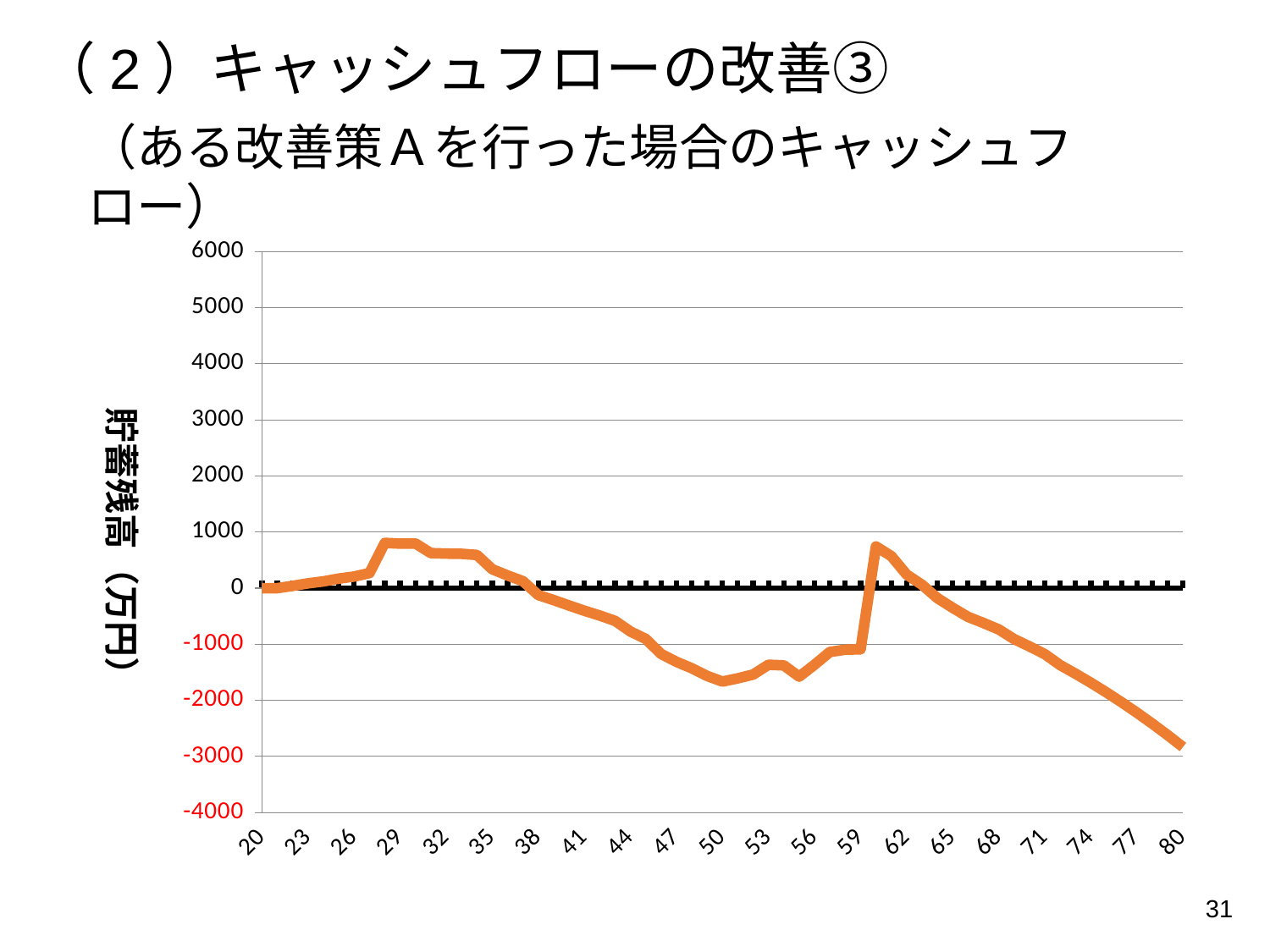
Is the value at age 44 greater or less than 0? less Is the value at age 74 greater or less than -1000? less Does the line rise or fall between age 62 and age 80? fall Is the value at age 80 greater or less than -2000? less What is the label of the vertical axis? 貯蓄残高（万円） What kind of chart is shown on the slide? line chart Does the line rise or fall between age 20 and age 29? rise What is the highest value shown on the vertical axis? 6000 At which age on the x axis does the line reach its lowest value? 80